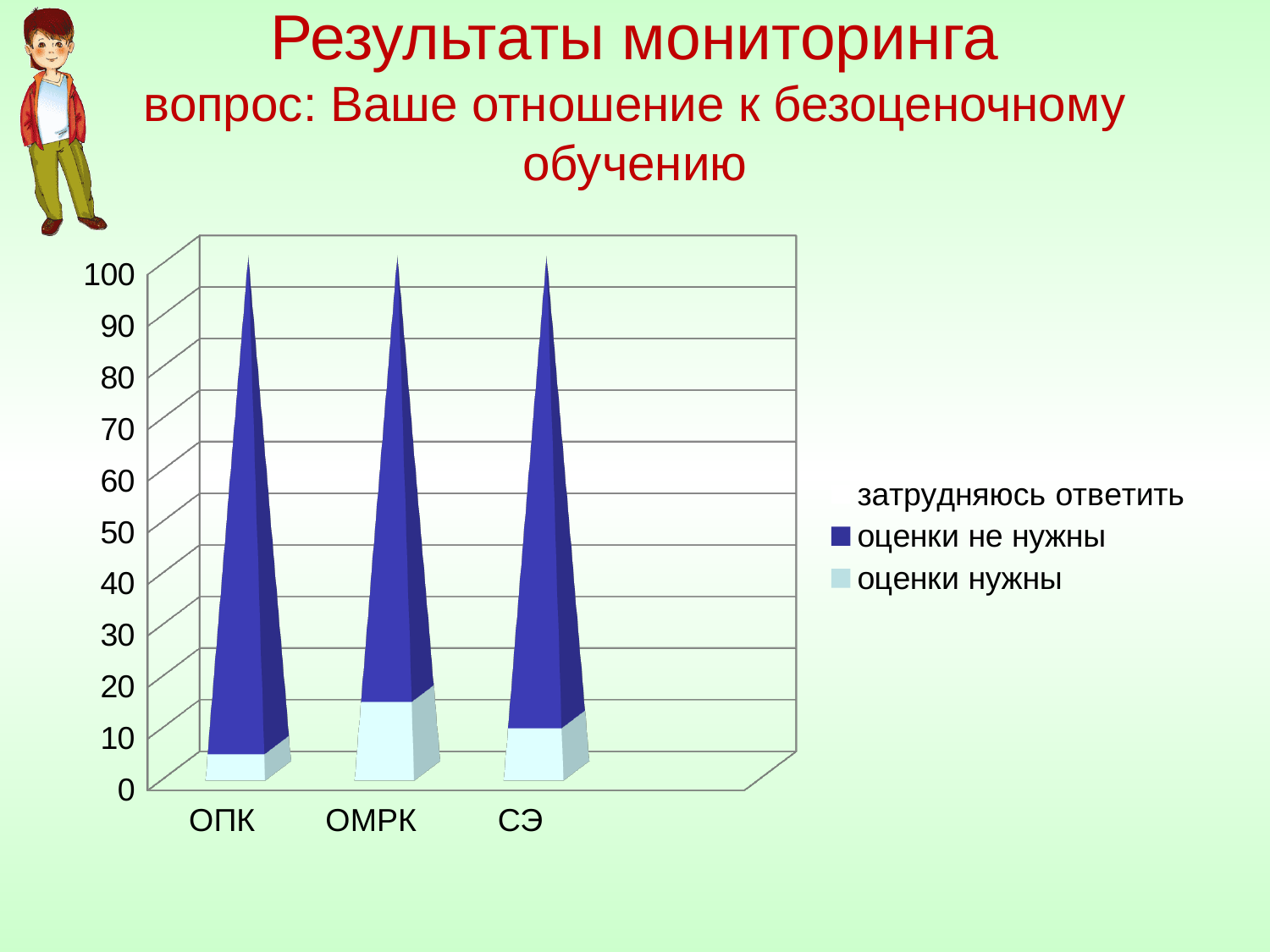
Is the value of 'оценки не нужны' for СЭ greater or less than 50? greater Which is larger: the 'оценки нужны' value for ОМРК or for ОПК? ОМРК Which legend entry is shown in dark blue? оценки не нужны Is the value of 'оценки нужны' for ОМРК greater or less than 10? greater Is the value of 'оценки нужны' for ОПК greater or less than 10? less What is the main title of the slide above the chart? Результаты мониторинга What kind of chart is shown on the slide? bar chart How many series does the chart legend list? 3 Which category has the largest value for the series 'оценки нужны'? ОМРК Which category has the smallest value for the series 'оценки нужны'? ОПК How many categories are shown on the x axis of the chart? 3